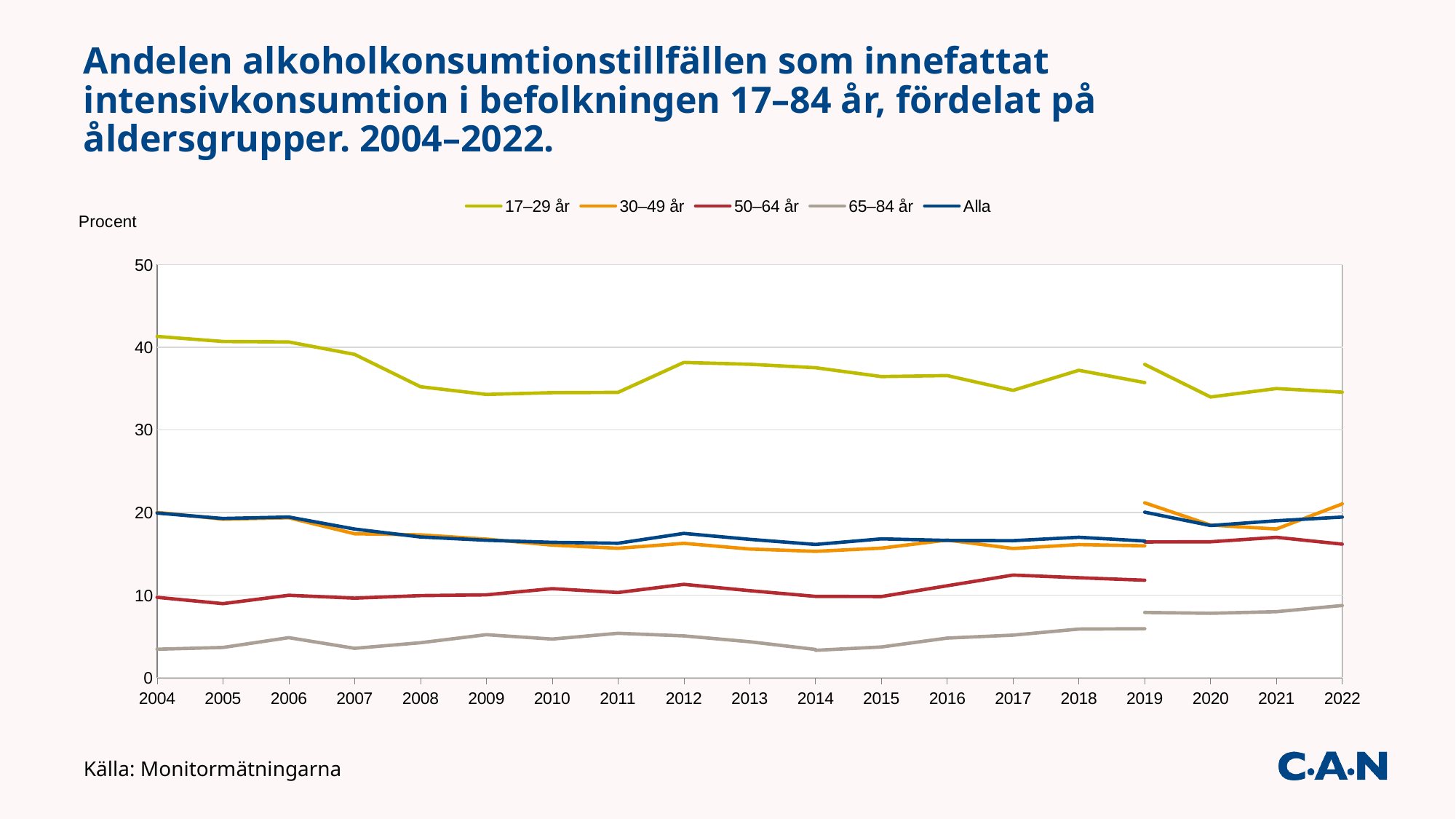
How many series does the legend list? 5 Which age group has the highest values throughout the period? 17–29 år What is the label on the y axis? Procent Is the value for 17–29 år in 2004 greater or less than 40? greater Is the value for 30–49 år in 2022 greater or less than 20? greater Which age group has the lowest values throughout the period? 65–84 år What kind of chart is shown on the slide? line chart Is the value for 65–84 år in 2014 greater or less than 10? less Does the 17–29 år line rise or fall from 2004 to 2011? fall Which is larger for 17–29 år: the value in 2004 or the value in 2022? 2004 How many years are shown along the x axis? 19